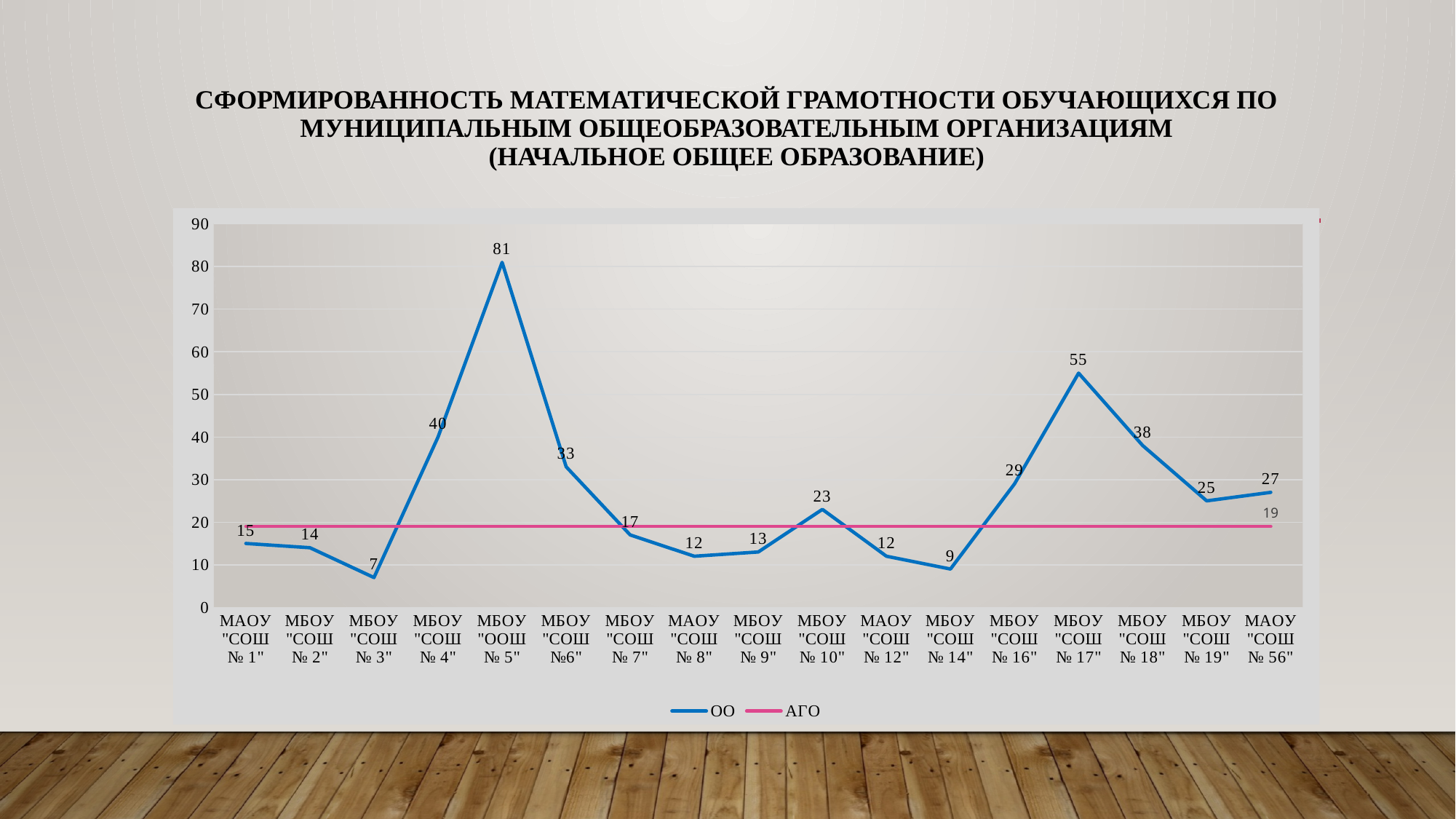
Is the ОО value for МБОУ "СОШ № 10" greater or less than the АГО value of 19? greater How many schools (categories) are plotted along the x axis? 17 What type of chart is shown on the slide? line chart What colour is the АГО line in the chart? pink How many series does the legend list? 2 Which has a larger ОО value, МБОУ "СОШ № 4" or МБОУ "СОШ № 18"? МБОУ "СОШ № 4" Which school has the highest ОО value? МБОУ "ООШ № 5" What is the ОО value for МБОУ "СОШ № 17"? 55 What is the value of the АГО line? 19 What is the difference between the ОО values for МБОУ "ООШ № 5" and МБОУ "СОШ № 17"? 26 Which school has the lowest ОО value? МБОУ "СОШ № 3" What is the ОО value for МБОУ "ООШ № 5"? 81